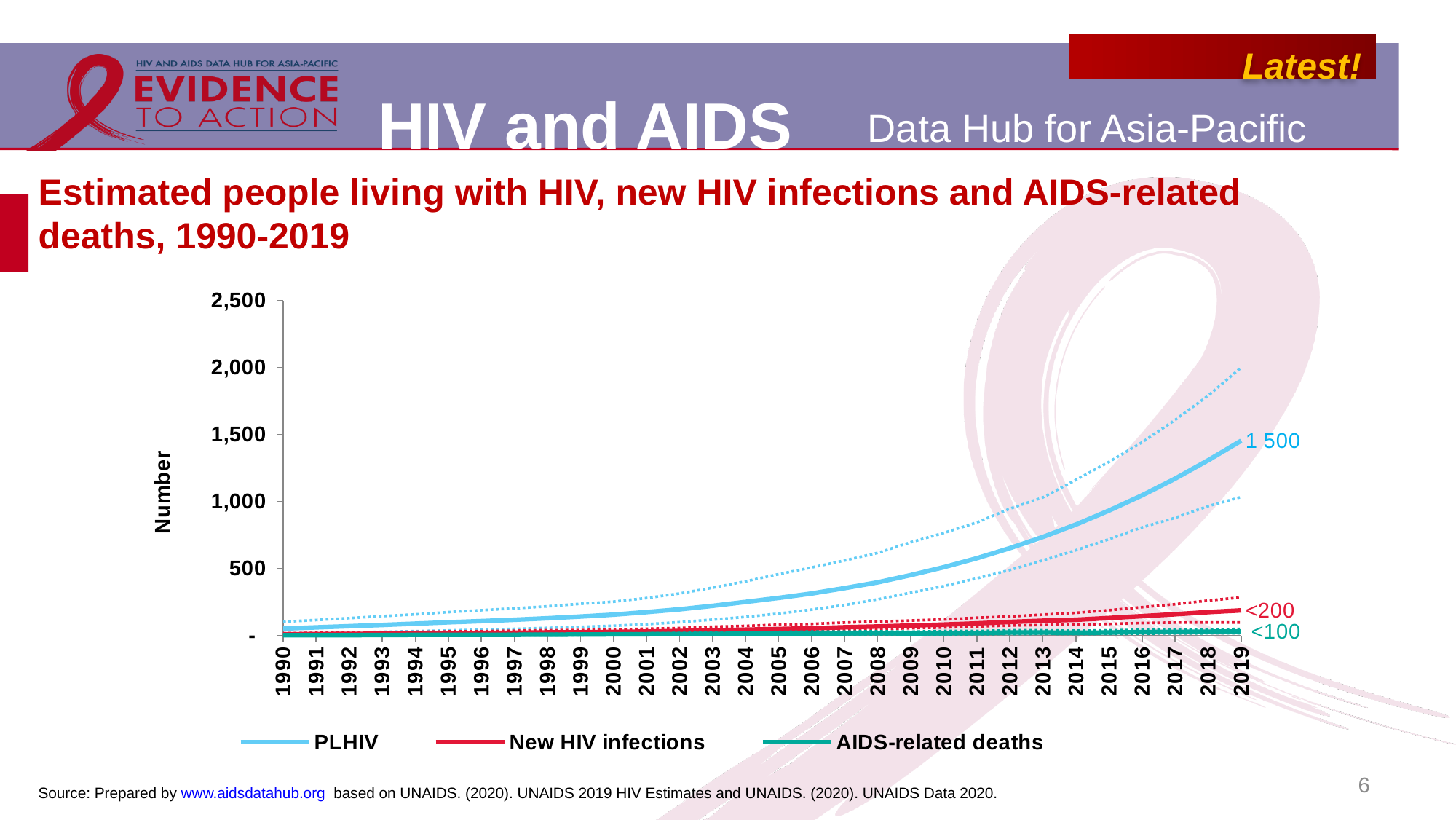
Does the PLHIV line rise or fall from 1990 to 2019? rise What is the labelled value for New HIV infections in 2019? <200 How many years are shown on the x axis? 30 Which series has the lowest value in 2019? AIDS-related deaths Which is larger in 2019, PLHIV or New HIV infections? PLHIV Which series has the highest value in 2019? PLHIV How many series does the legend list? 3 What is the label of the y axis? Number What type of chart is shown on the slide? line chart What is the labelled value for PLHIV in 2019? 1 500 What is the labelled value for AIDS-related deaths in 2019? <100 Is the value for PLHIV in 2010 greater or less than 1,000? less